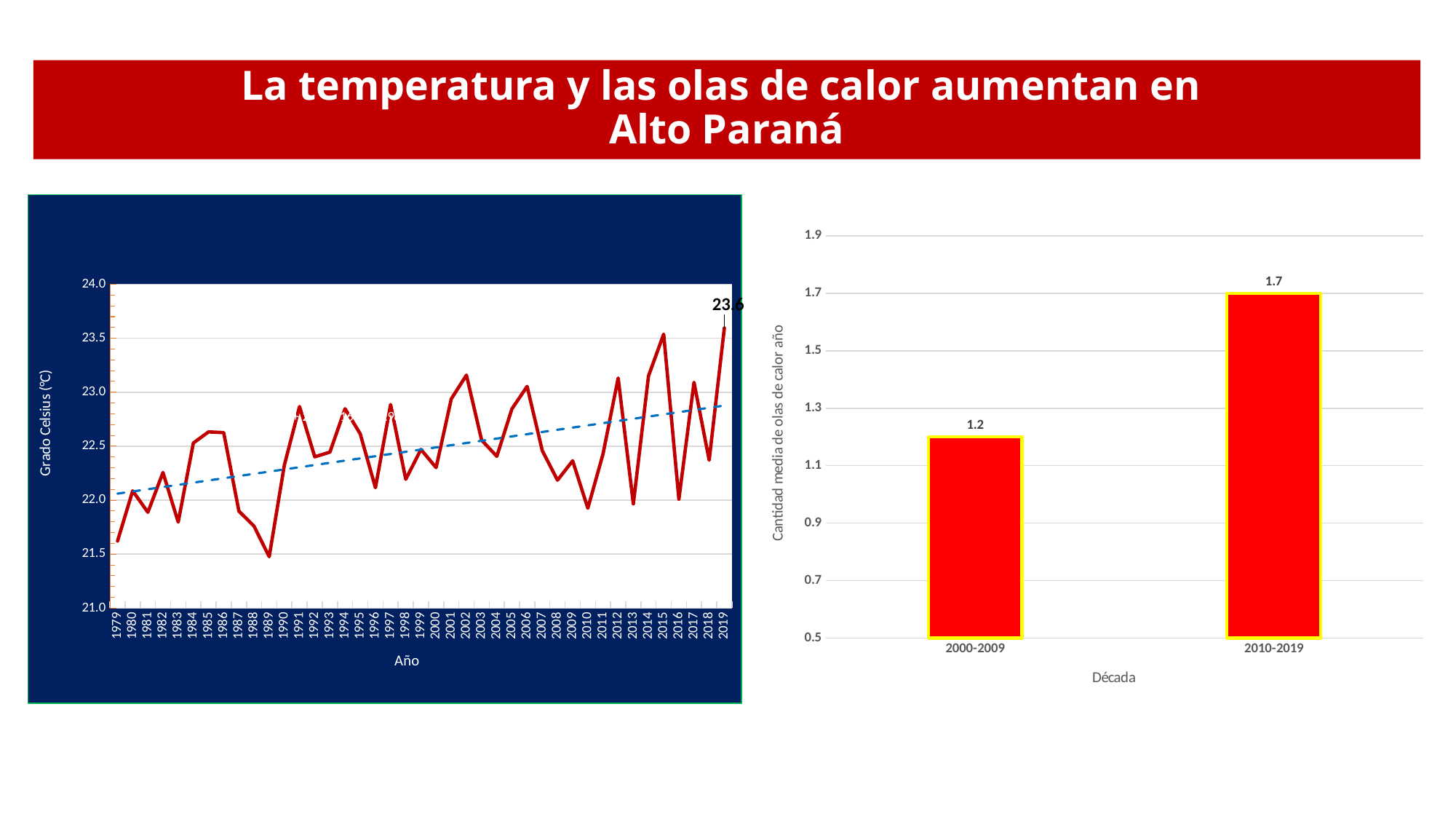
In the line chart on the left, do the values generally rise or fall from 1979 to 2019? Rise In the line chart on the left, what is the value for 2019? 23.6 In the bar chart on the right, how many decades are shown? 2 In the bar chart on the right, what is the value for 2010-2019? 1.7 In the bar chart on the right, which decade has the higher value? 2010-2019 In the bar chart on the right, what is the value for 2000-2009? 1.2 In the bar chart on the right, what is the title of the vertical axis? Cantidad media de olas de calor año In the bar chart on the right, what is the difference between the values for 2010-2019 and 2000-2009? 0.5 What kind of chart is the chart on the left? Line chart In the line chart on the left, is the value for 2015 greater or less than 23.0? greater In the line chart on the left, is the value for 1979 greater or less than 22.0? less What kind of chart is the chart on the right? Bar chart